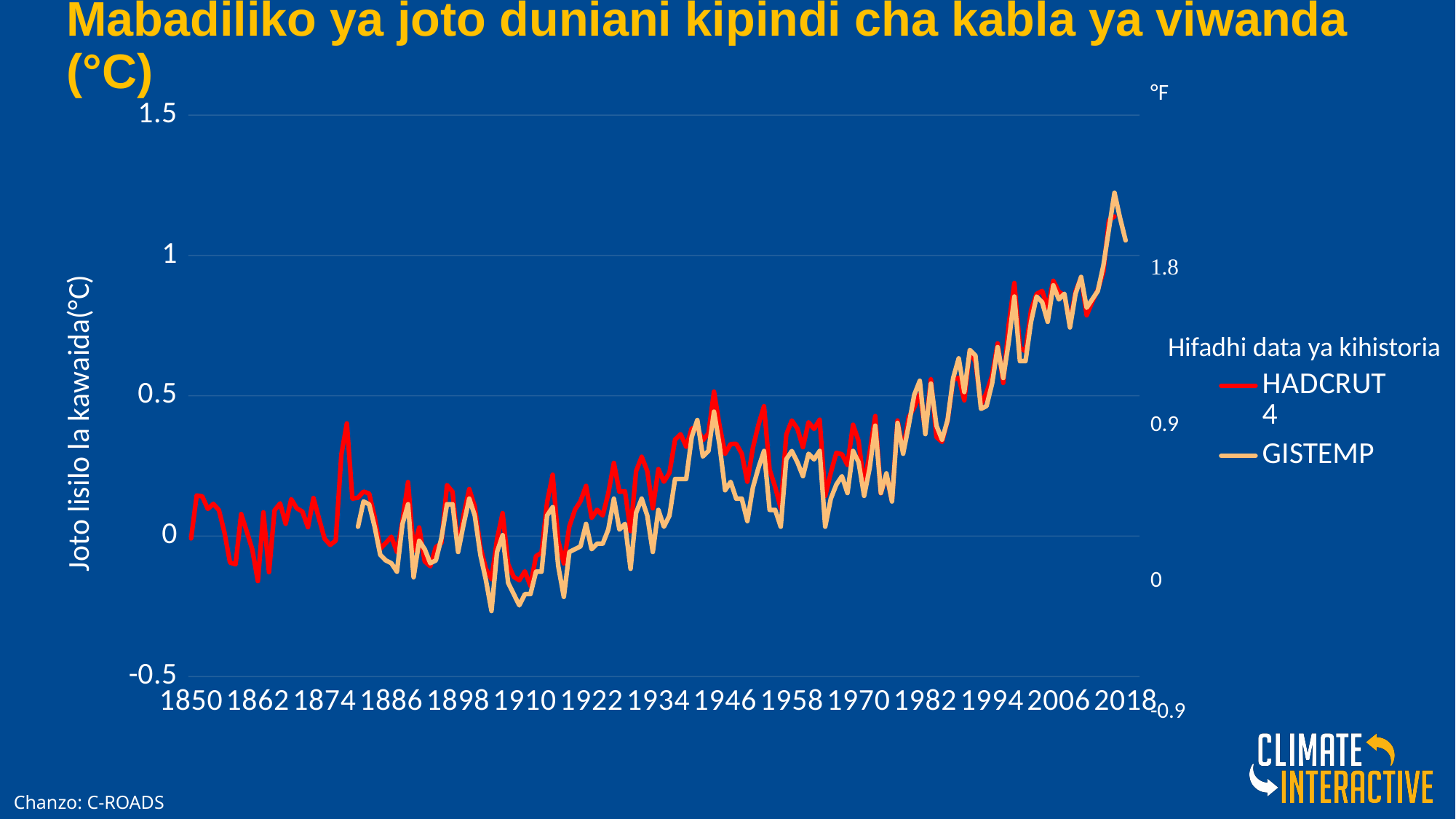
What kind of chart is shown on the slide? line chart How many year labels are shown on the x axis? 15 Which two series are listed in the legend? HADCRUT4 and GISTEMP What is the label on the left vertical axis? Joto lisilo la kawaida(°C) Overall, do the temperature values rise or fall from 1850 to 2018? rise What is the first year shown on the x axis? 1850 What is the highest value shown on the left vertical axis? 1.5 How many series does the legend list? 2 Is the HADCRUT4 value in 1850 greater or less than 0.5? less Is the HADCRUT4 value around 2006 greater or less than 0.5? greater Is the peak GISTEMP value near 2016 greater or less than 1? greater